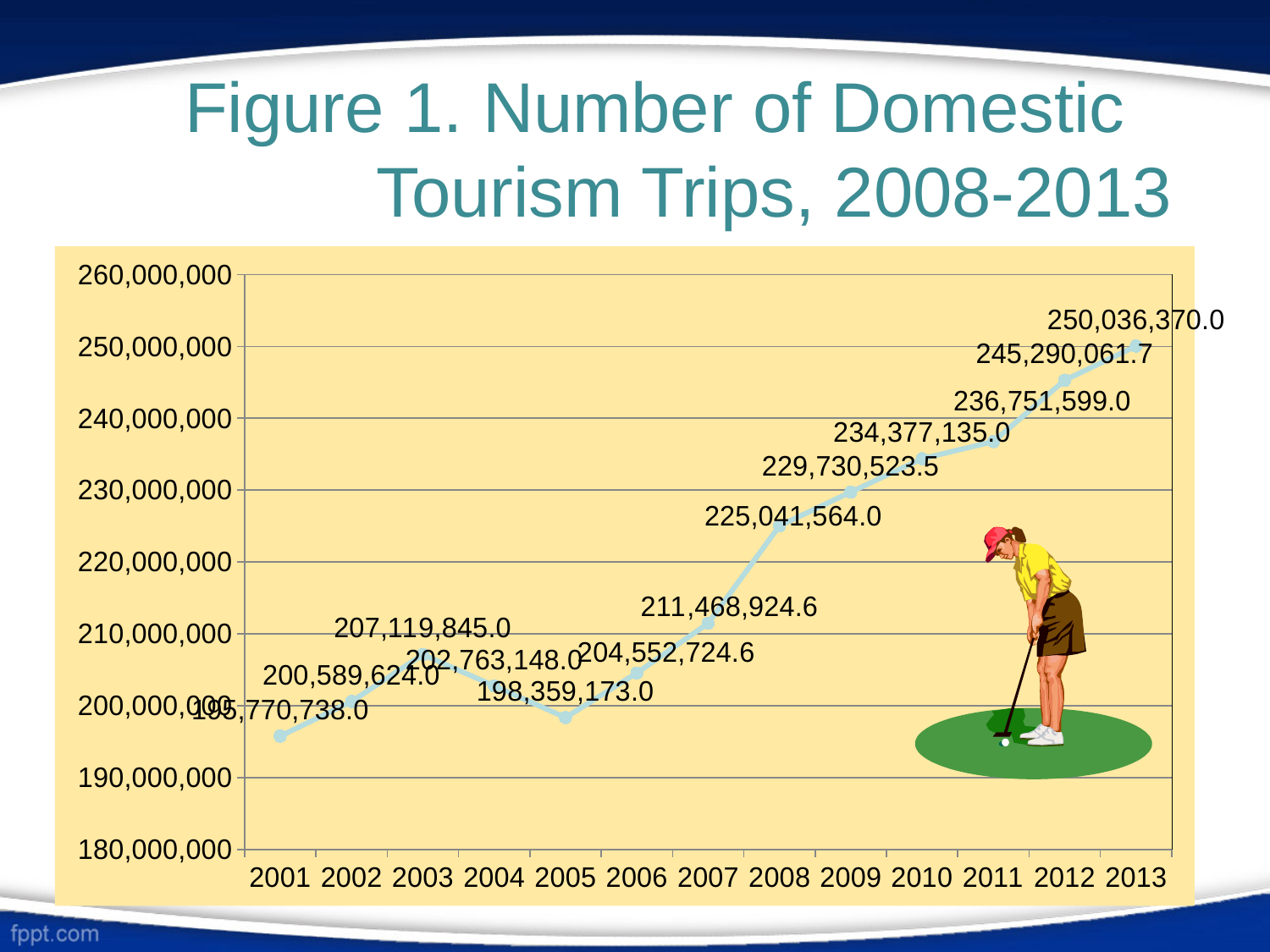
What is the difference between the 2013 and 2012 values? 4,746,308.3 What type of chart is shown on the slide? line chart Do the values generally rise or fall from 2005 to 2013? rise What is the value plotted for 2005? 198,359,173.0 Which year has the lowest number of domestic tourism trips? 2001 Which year has the highest number of domestic tourism trips? 2013 What is the number of domestic tourism trips in 2008? 225,041,564.0 What is the number of domestic tourism trips in 2013? 250,036,370.0 Which year has the larger value, 2003 or 2004? 2003 Is the value for 2005 greater or less than 200,000,000? less How many years are plotted on the x axis? 13 What is the value plotted for 2010? 234,377,135.0